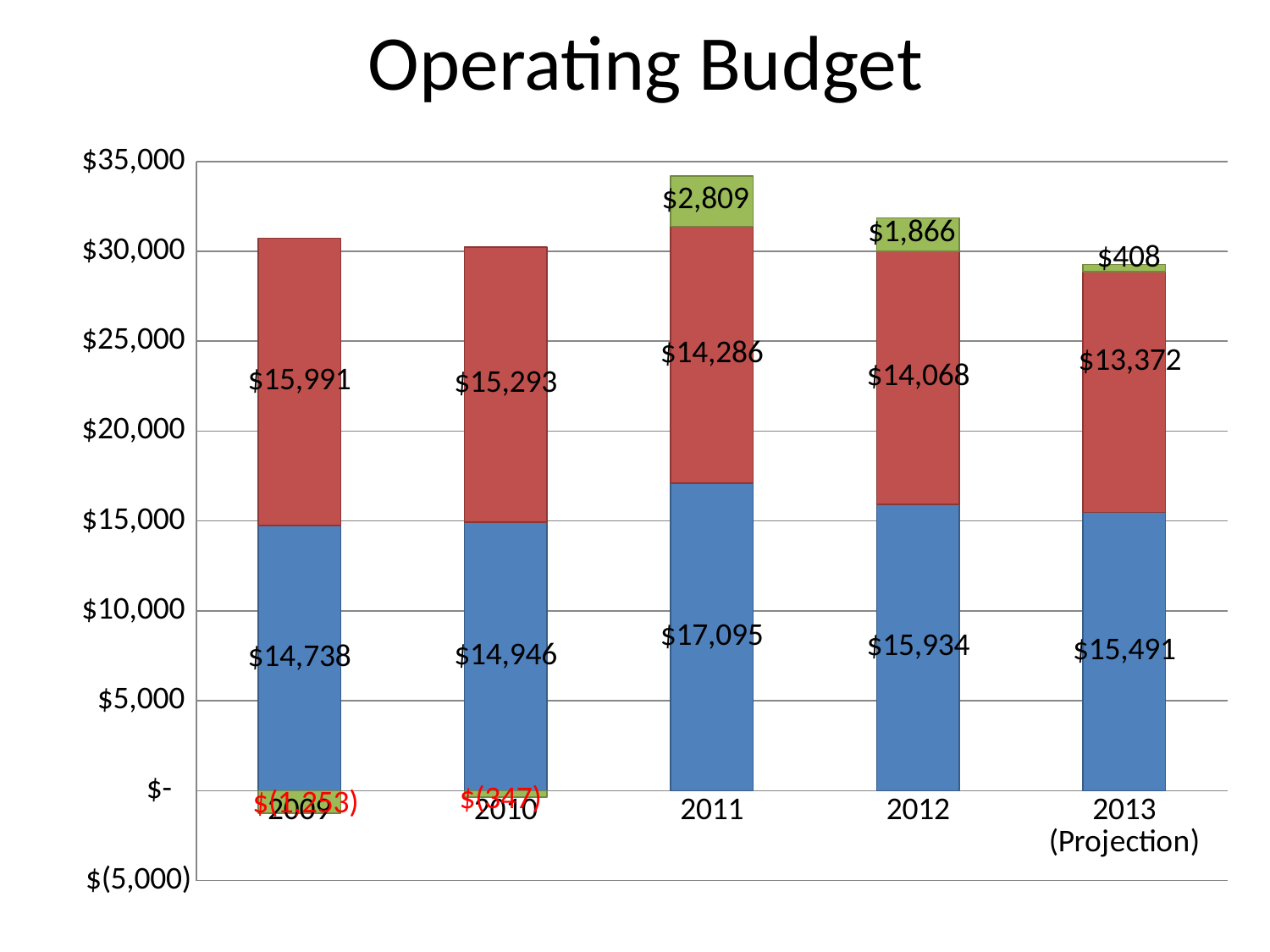
Which year has the larger blue segment, 2010 or 2012? 2012 What is the value of the green segment for 2011? $2,809 What is the value of the green segment for 2010? $(347) In which year is the blue segment the largest? 2011 How many years (categories) are shown on the x axis? 5 In which year is the red segment the smallest? 2013 (Projection) What is the title of the chart? Operating Budget What is the value of the blue segment for 2011? $17,095 What kind of chart is shown on the slide? stacked bar chart What is the value of the red segment for 2013 (Projection)? $13,372 Do the red segment values rise or fall from 2009 to 2013 (Projection)? fall What is the difference between the red segment values for 2009 and 2010? $698